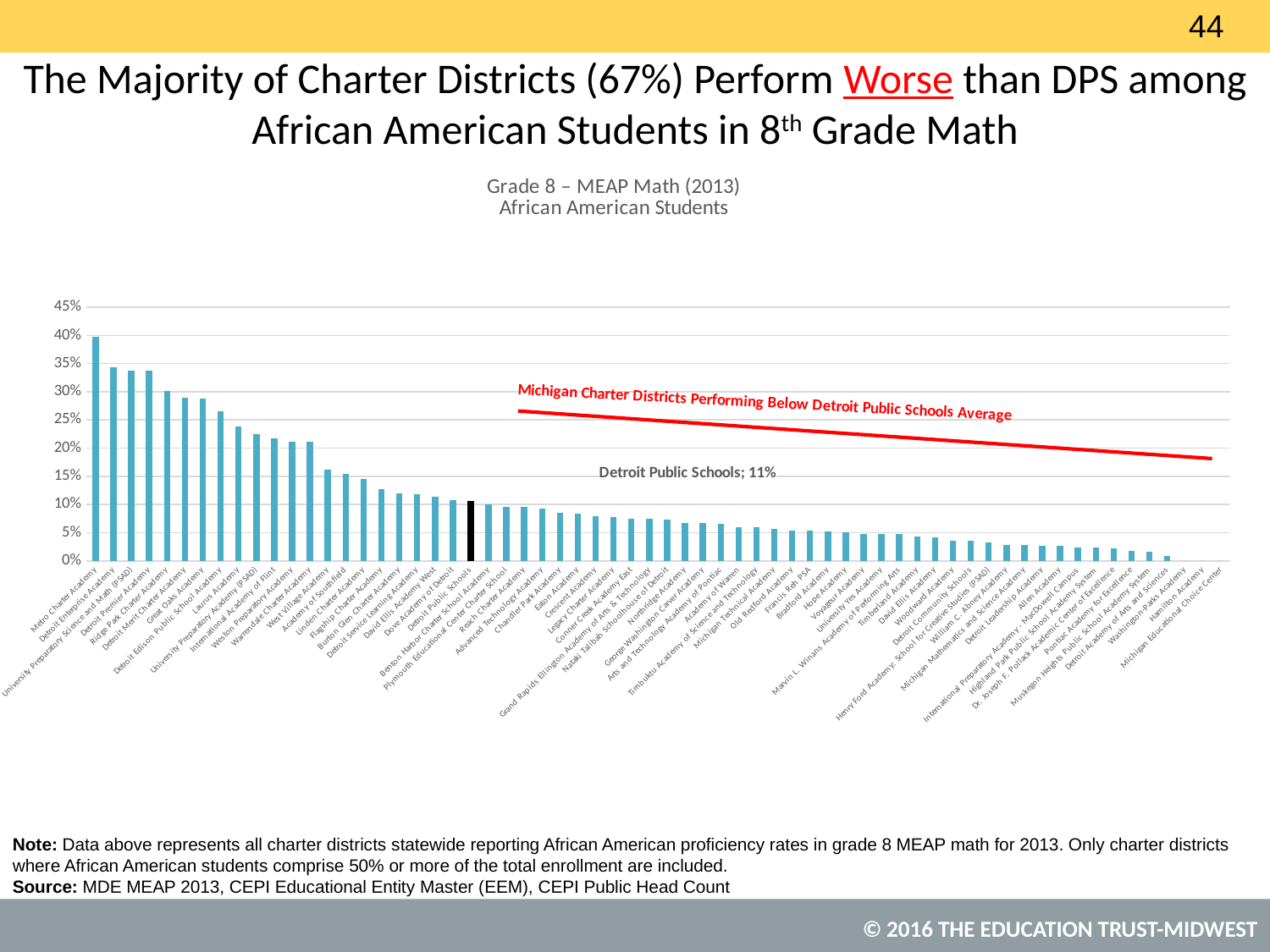
What kind of chart is shown on the slide? bar chart Which district has the highest bar in the chart? Metro Charter Academy Do the bar values rise or fall moving from left to right along the x axis? fall Is the value for Metro Charter Academy greater or less than 35%? greater What colour is the bar for Detroit Public Schools? black What is the proficiency rate shown for Detroit Public Schools? 11% Is the value for Detroit Enterprise Academy greater or less than 30%? greater What is the title printed above the chart? Grade 8 – MEAP Math (2013) African American Students Which is larger, the value for Metro Charter Academy or the value for Detroit Public Schools? Metro Charter Academy